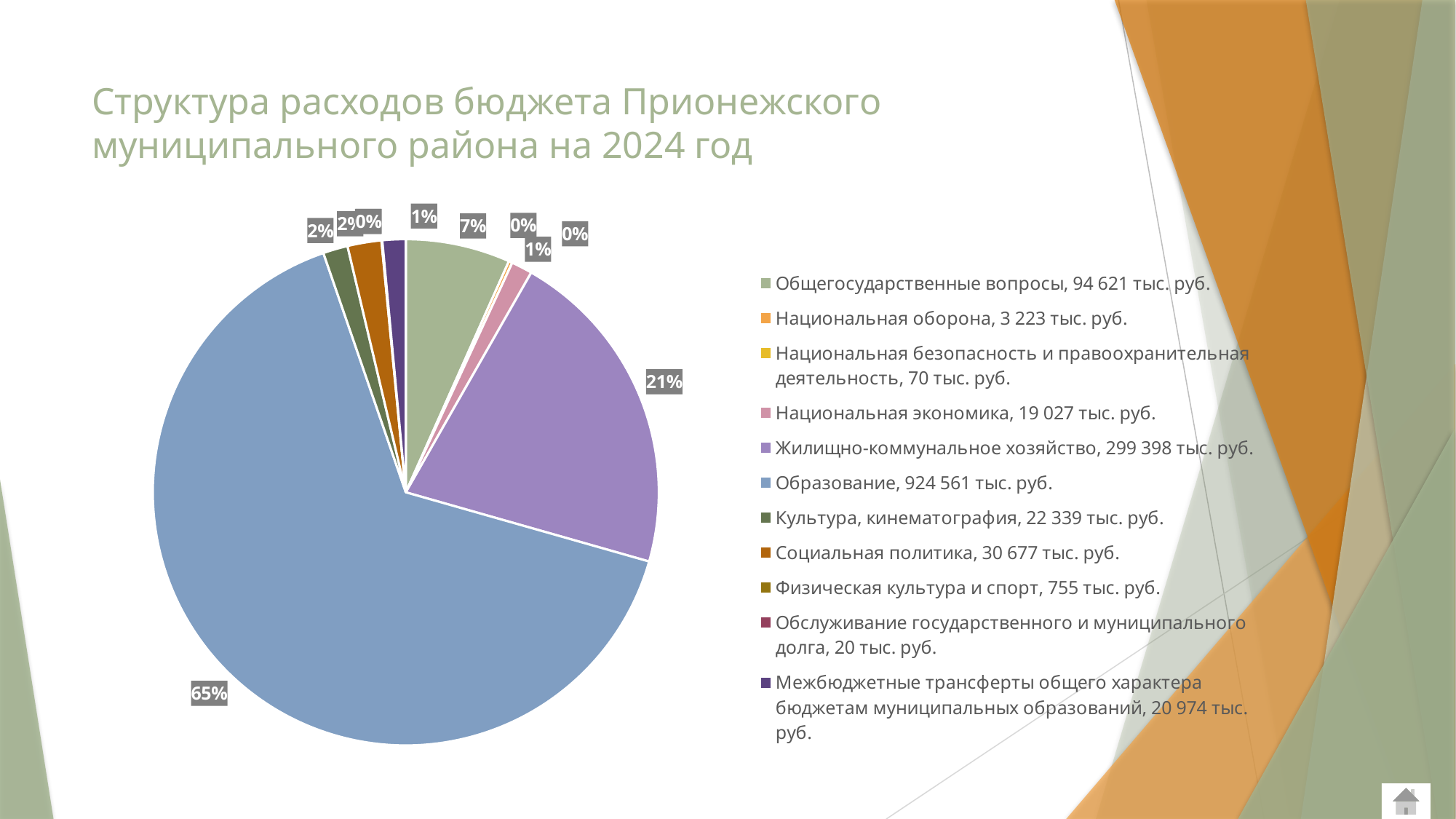
What is the difference in percentage points between the share for Образование and the share for Жилищно-коммунальное хозяйство? 44% How many categories does the pie chart have? 11 Which category has the largest share of the pie? Образование What share of the pie does Образование have? 65% What share of the pie does Общегосударственные вопросы have? 7% What share of the pie does Жилищно-коммунальное хозяйство have? 21% What kind of chart is shown on the slide? pie chart What is the title of the slide? Структура расходов бюджета Прионежского муниципального района на 2024 год What is the value for Образование according to the legend? 924 561 тыс. руб. What is the value for Жилищно-коммунальное хозяйство according to the legend? 299 398 тыс. руб. Which is larger, the share for Образование or the share for Жилищно-коммунальное хозяйство? Образование What is the value for Национальная оборона according to the legend? 3 223 тыс. руб.